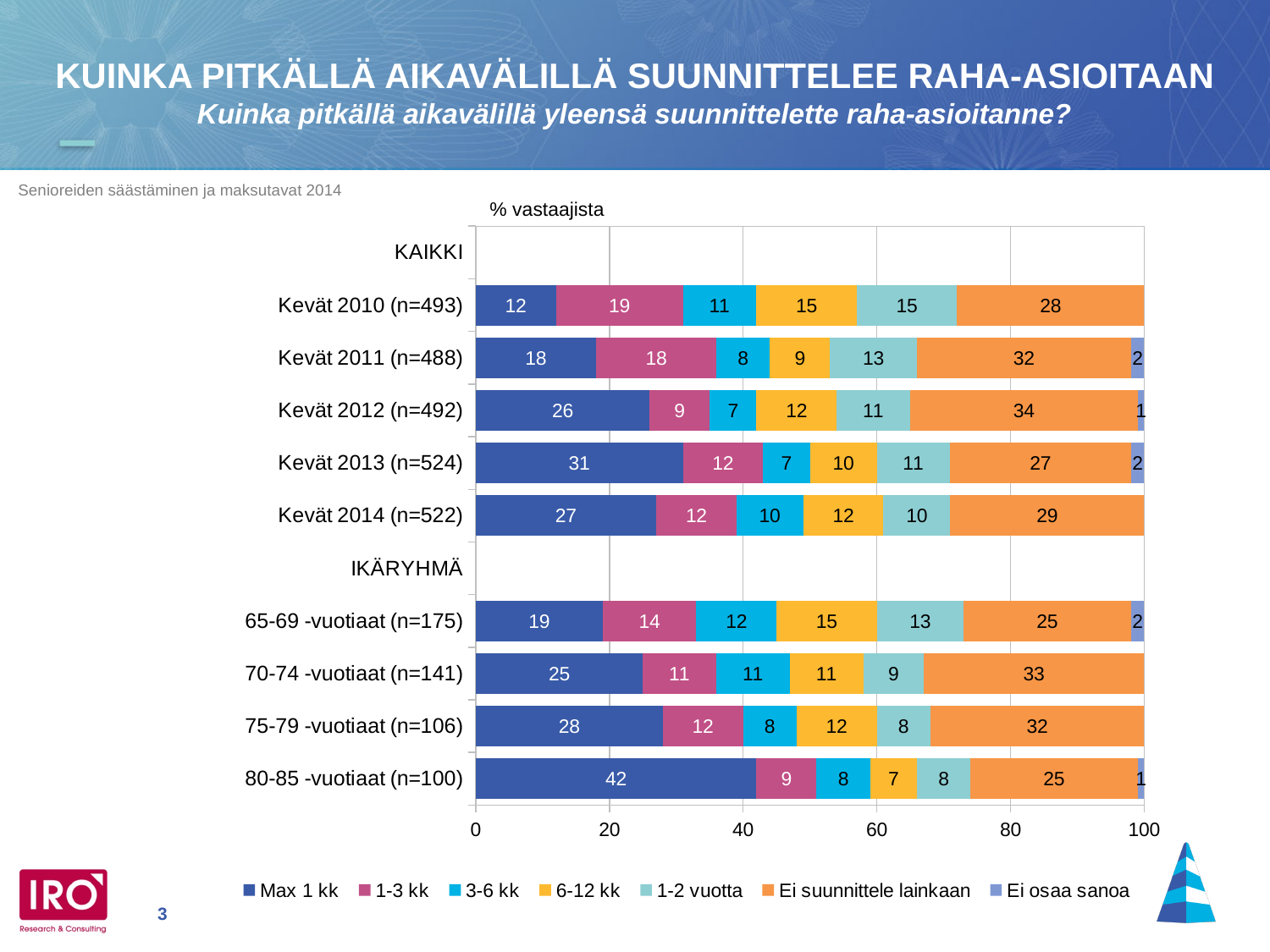
What is the difference between the 'Max 1 kk' values for Kevät 2013 (n=524) and Kevät 2010 (n=493)? 19 What is the value of 'Ei suunnittele lainkaan' for Kevät 2012 (n=492)? 34 How many series does the legend list? 7 Which is larger: the 'Ei suunnittele lainkaan' value for 70-74 -vuotiaat (n=141) or for 65-69 -vuotiaat (n=175)? 70-74 -vuotiaat (n=141) What is the label shown above the chart's plot area? % vastaajista What is the total of the stacked bar for Kevät 2011 (n=488)? 100 What is the value of 'Max 1 kk' for Kevät 2014 (n=522)? 27 Which category has the highest value for 'Max 1 kk'? 80-85 -vuotiaat (n=100) What kind of chart is shown on the slide? Stacked bar chart Which category has the lowest value for 'Max 1 kk'? Kevät 2010 (n=493) What is the value of '1-3 kk' for 65-69 -vuotiaat (n=175)? 14 What is the value of '6-12 kk' for 80-85 -vuotiaat (n=100)? 7